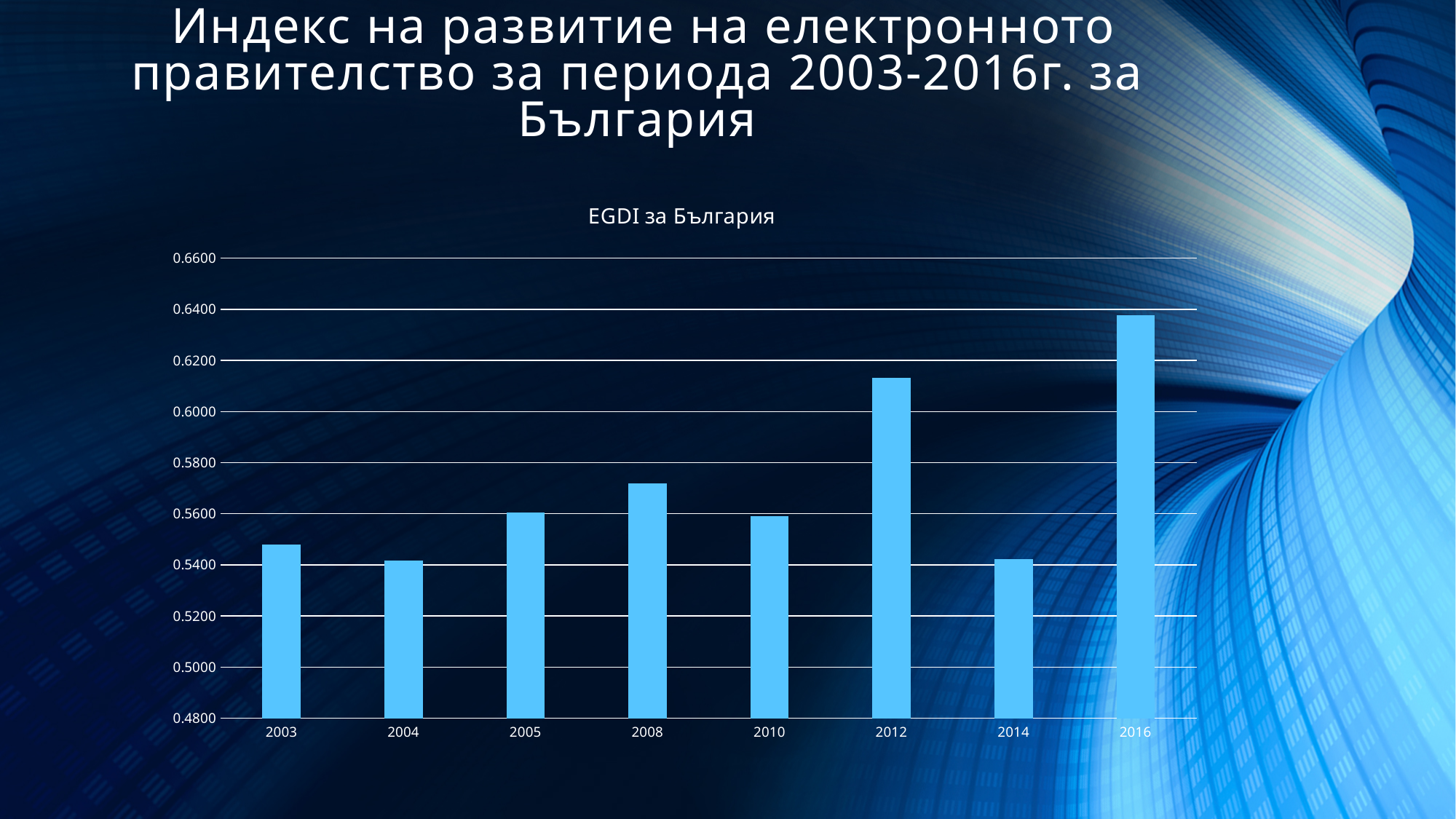
Is the value for 2016 greater or less than 0.6200? greater What kind of chart is shown on the slide? bar chart Overall, do the values rise or fall from 2003 to 2016? rise Which year has the highest EGDI value? 2016 Is the value for 2008 greater or less than 0.5800? less Which is larger, the value for 2005 or the value for 2003? 2005 Is the value for 2012 greater or less than 0.6000? greater Which is larger, the value for 2012 or the value for 2008? 2012 What is the title of the chart? EGDI за България How many years are shown on the x axis of the chart? 8